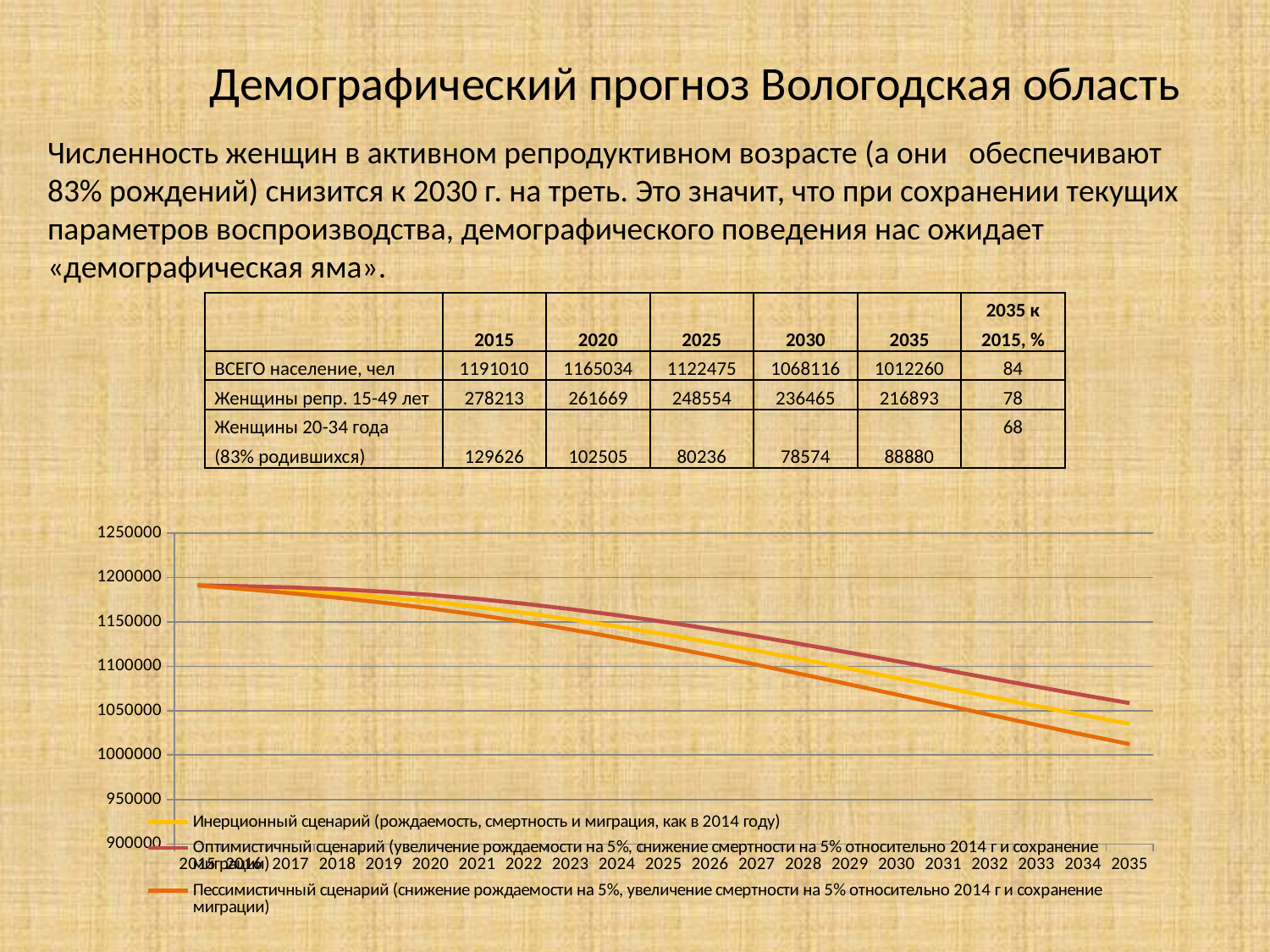
In 2035, which is larger: the value of the Инерционный сценарий or the Пессимистичный сценарий? Инерционный сценарий Is the value of the Инерционный сценарий in 2015 greater or less than 1150000? greater What colour is the line for the Инерционный сценарий in the chart? yellow Which scenario has the highest value in 2035? Оптимистичный сценарий What kind of chart is shown on the slide? line chart What is the first year shown on the x axis of the chart? 2015 How many years are shown along the x axis of the chart? 21 Is the value of the Пессимистичный сценарий in 2035 greater or less than 1050000? less Do the values of the Пессимистичный сценарий line rise or fall from 2015 to 2035? fall How many series does the chart's legend list? 3 Which scenario has the lowest value in 2035? Пессимистичный сценарий Is the value of the Оптимистичный сценарий in 2035 greater or less than 1000000? greater